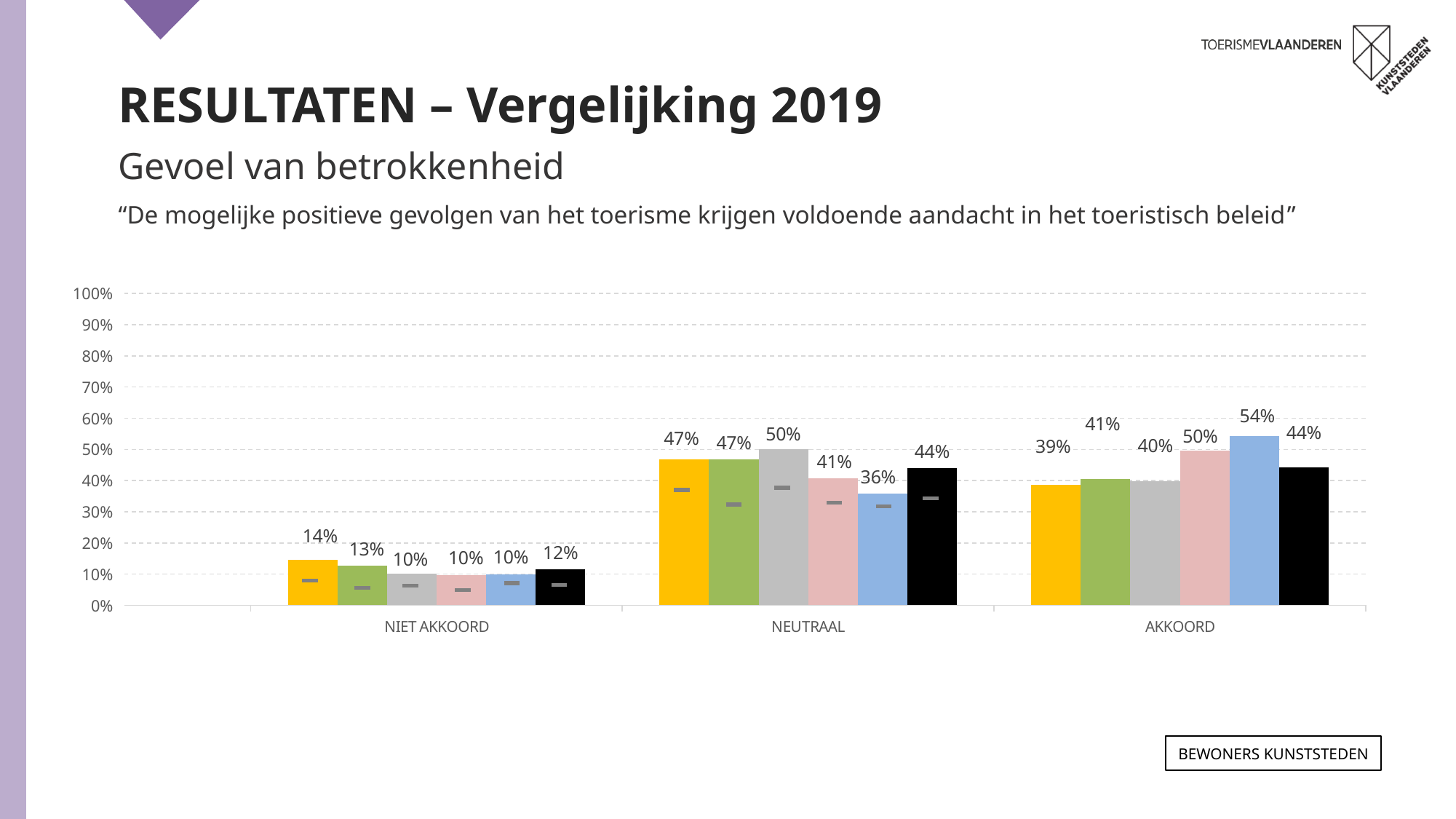
What is the value of the grey bar in the NEUTRAAL category? 50% Which bar has the lowest value in the NEUTRAAL category? the blue bar (36%) How many bars are shown in each category of the chart? 6 What is the value of the black bar in the NEUTRAAL category? 44% Which bar has the highest value in the AKKOORD category? the blue bar (54%) What type of chart is shown on the slide? bar chart Which is larger in the NEUTRAAL category: the pink bar or the blue bar? the pink bar How many categories are shown on the x axis of the chart? 3 What is the value of the blue bar in the AKKOORD category? 54% Is the value of the pink bar in the AKKOORD category greater or less than 40%? greater What is the difference between the blue bar and the yellow bar in the AKKOORD category? 15% What is the value of the yellow bar in the NIET AKKOORD category? 14%